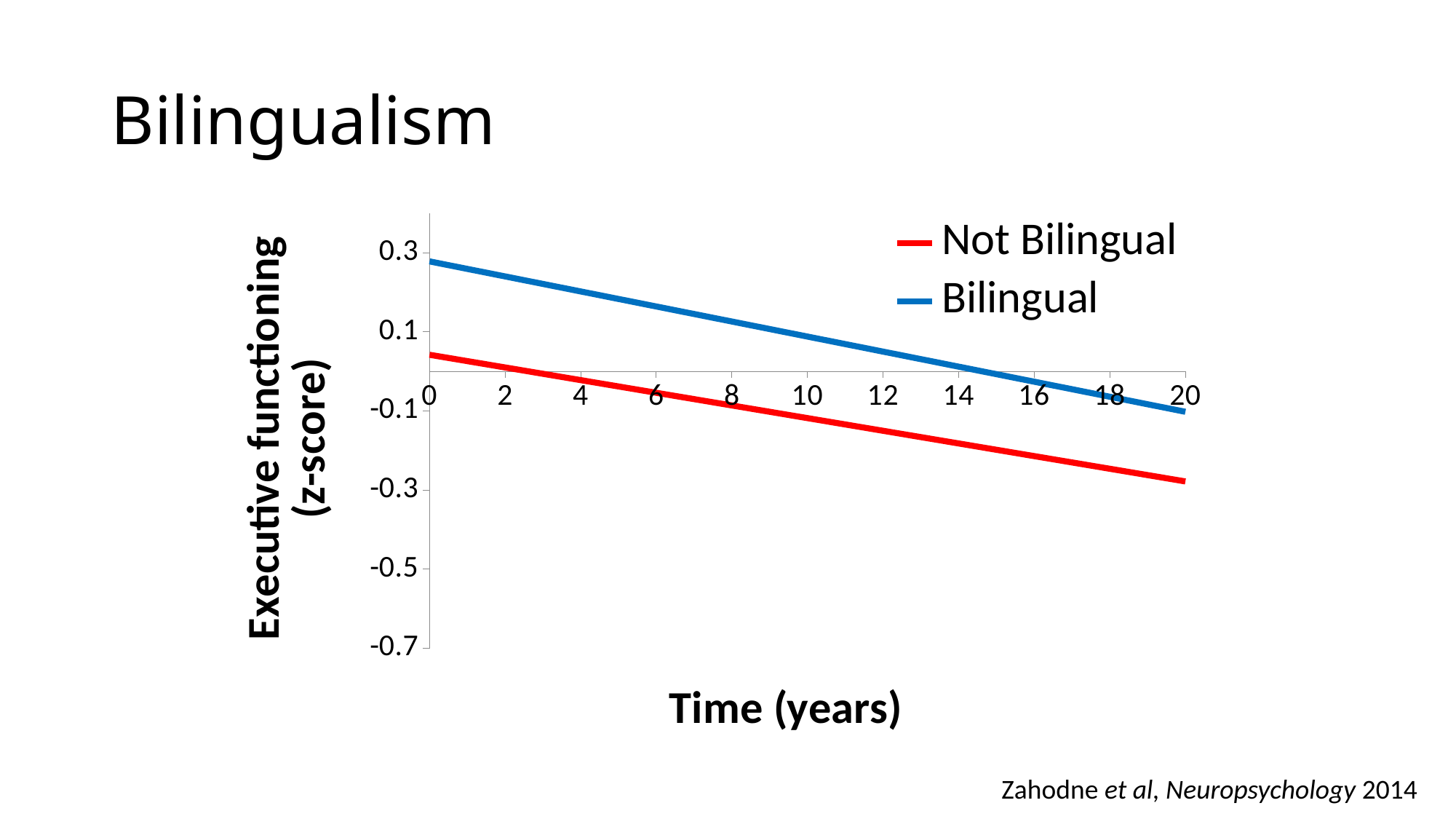
Is the value for Not Bilingual at time 20 years greater or less than -0.1? less How many series does the legend list? 2 What is the label of the y axis? Executive functioning (z-score) Is the value for Bilingual at time 4 years greater or less than 0.1? greater Does the Bilingual line rise or fall as time increases? fall At time 0 years, which series has the higher executive functioning z-score, Bilingual or Not Bilingual? Bilingual Is the value for Bilingual at time 0 years greater or less than 0.1? greater At time 20 years, which series has the higher executive functioning z-score, Bilingual or Not Bilingual? Bilingual Which series is shown in red? Not Bilingual What kind of chart is shown on the slide? line chart Does the Not Bilingual line rise or fall as time increases? fall